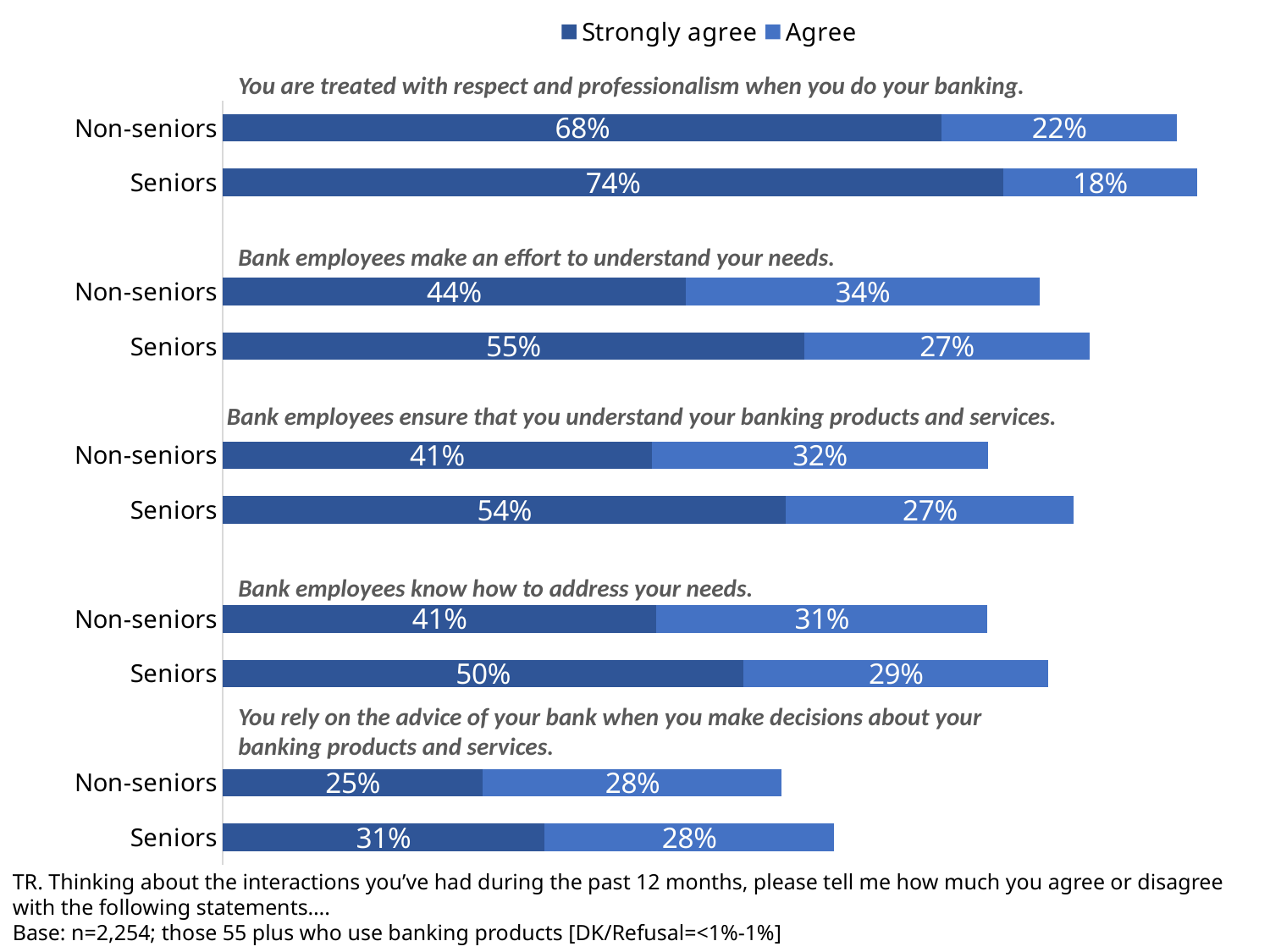
What percentage of Non-seniors agree (not strongly) that bank employees make an effort to understand their needs? 34% What type of chart is shown on the slide? Stacked bar chart How many statements are shown on the chart? 5 What percentage of Seniors strongly agree that they are treated with respect and professionalism when they do their banking? 74% What is the combined total of 'Strongly agree' and 'Agree' for Non-seniors on the statement 'You rely on the advice of your bank when you make decisions about your banking products and services'? 53% What is the combined total of 'Strongly agree' and 'Agree' for Seniors on the statement 'You are treated with respect and professionalism when you do your banking'? 92% What is the 'Strongly agree' value for Non-seniors on the statement 'Bank employees know how to address your needs'? 41% How much higher is the 'Strongly agree' share for Seniors than for Non-seniors on the statement 'Bank employees ensure that you understand your banking products and services'? 13 percentage points For the statement 'Bank employees make an effort to understand your needs', which group has the larger 'Strongly agree' share, Seniors or Non-seniors? Seniors Across all statements, which group and statement has the highest 'Strongly agree' value? Seniors, 'You are treated with respect and professionalism when you do your banking' (74%) How many series does the legend list? 2 Across all statements, which group and statement has the lowest 'Strongly agree' value? Non-seniors, 'You rely on the advice of your bank when you make decisions about your banking products and services' (25%)